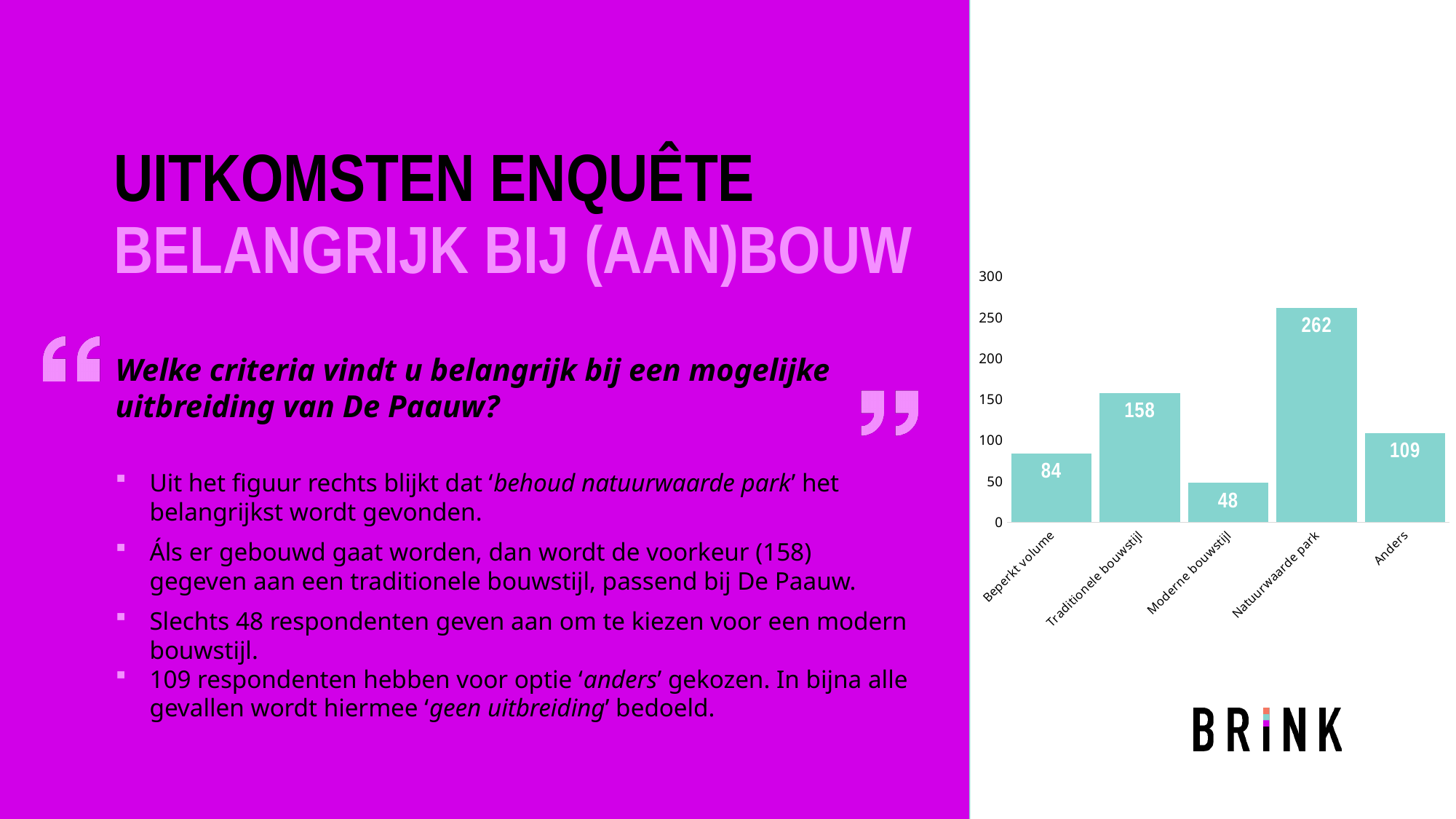
What is the value for Natuurwaarde park? 262 Which category has the highest value? Natuurwaarde park Is the value for Beperkt volume greater or less than 100? less Which is larger, the value for Beperkt volume or the value for Anders? Anders How many categories are shown on the x axis? 5 What is the value for Traditionele bouwstijl? 158 What is the value for Anders? 109 What kind of chart is shown on the slide? bar chart What is the highest value shown on the y axis? 300 What is the value for Moderne bouwstijl? 48 Which category has the lowest value? Moderne bouwstijl What is the difference between the values for Natuurwaarde park and Traditionele bouwstijl? 104